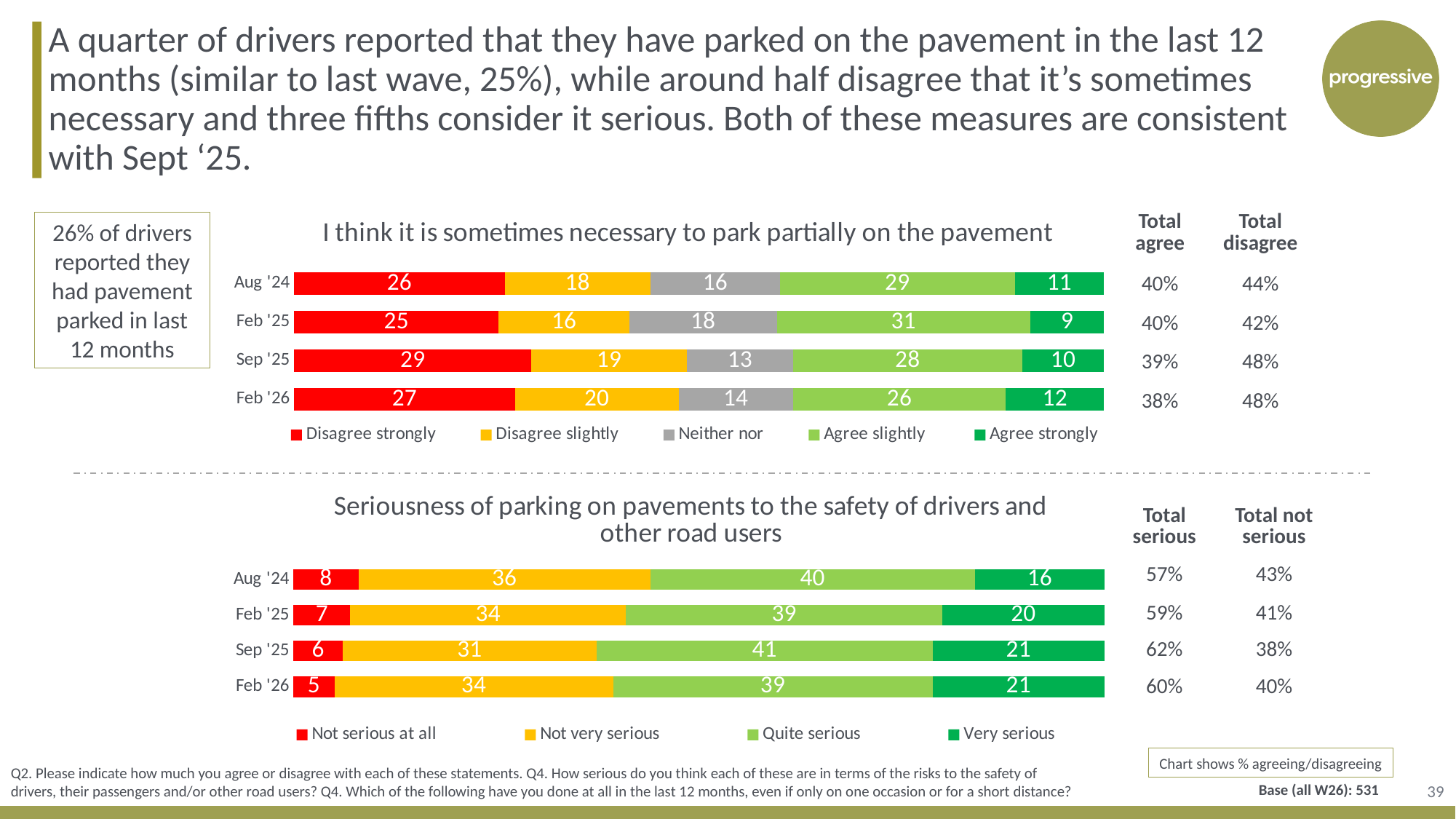
How many series does the legend of the chart 'I think it is sometimes necessary to park partially on the pavement' list? 5 In the chart 'I think it is sometimes necessary to park partially on the pavement', what is the difference between the Disagree slightly values for Feb '26 and Feb '25? 4 In the chart 'I think it is sometimes necessary to park partially on the pavement', which wave has the lowest Neither nor value? Sep '25 In the chart 'Seriousness of parking on pavements to the safety of drivers and other road users', what is the total of the stacked bar for Aug '24? 100 In the chart 'Seriousness of parking on pavements to the safety of drivers and other road users', is the Very serious value larger for Aug '24 or Feb '25? Feb '25 In the chart 'Seriousness of parking on pavements to the safety of drivers and other road users', what is the value for Quite serious in Sep '25? 41 In the chart 'I think it is sometimes necessary to park partially on the pavement', which wave has the highest Agree strongly value? Feb '26 In the chart 'I think it is sometimes necessary to park partially on the pavement', what is the value for Disagree strongly in Sep '25? 29 What kind of chart is the chart 'Seriousness of parking on pavements to the safety of drivers and other road users'? Stacked bar chart In the chart 'Seriousness of parking on pavements to the safety of drivers and other road users', which wave has the lowest Not serious at all value? Feb '26 How many waves (bars) are shown in the chart 'Seriousness of parking on pavements to the safety of drivers and other road users'? 4 In the chart 'I think it is sometimes necessary to park partially on the pavement', what is the value for Agree slightly in Feb '25? 31